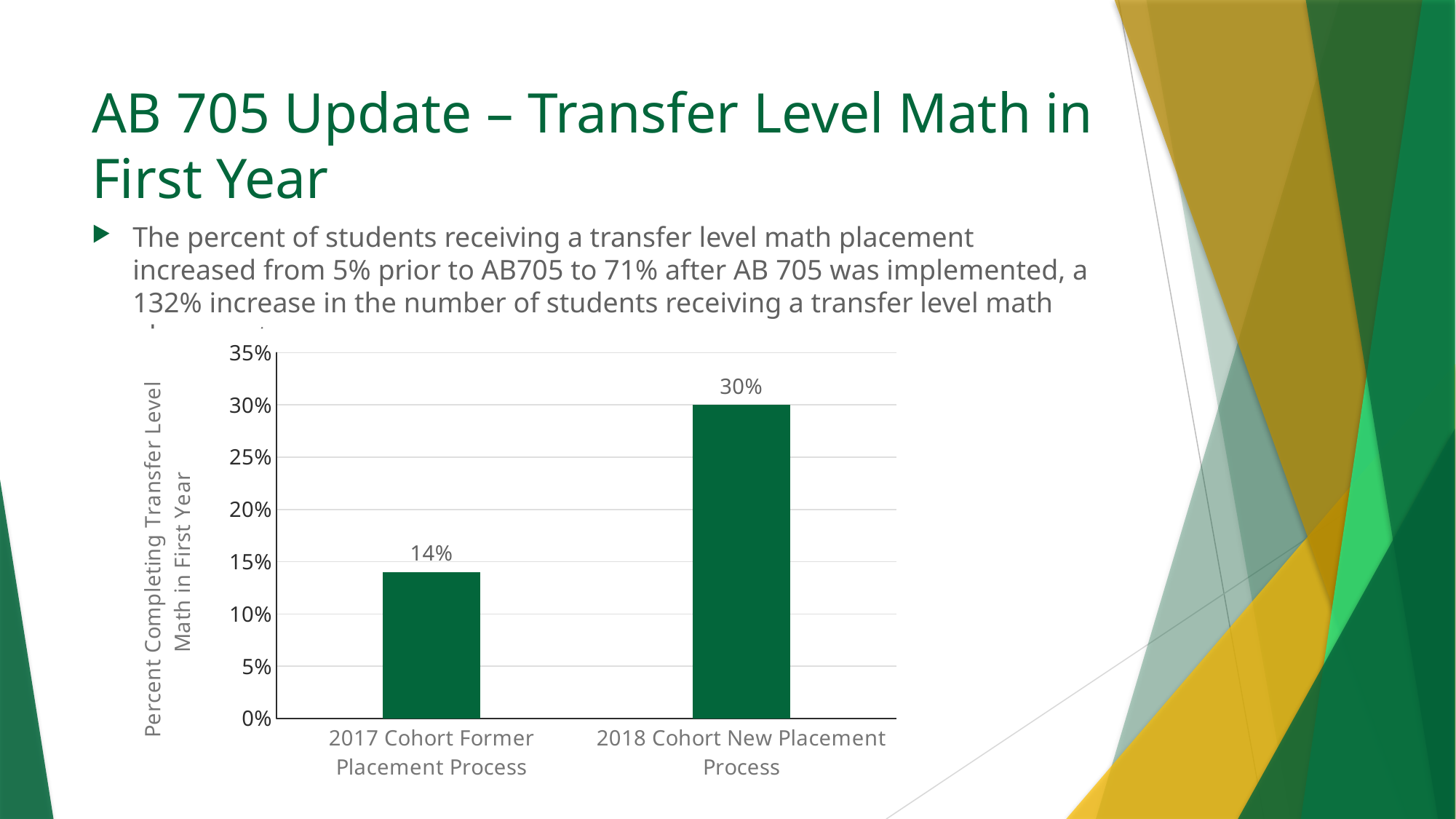
What is the label of the vertical axis? Percent Completing Transfer Level Math in First Year How many categories are shown on the x axis? 2 Do the values rise or fall from the 2017 cohort to the 2018 cohort? rise What is the value for 2017 Cohort Former Placement Process? 14% What kind of chart is shown on the slide? bar chart What is the difference between the values for 2018 Cohort New Placement Process and 2017 Cohort Former Placement Process? 16% Is the value for 2017 Cohort Former Placement Process greater or less than 20%? less What is the value for 2018 Cohort New Placement Process? 30% Which is larger, the value for 2017 Cohort Former Placement Process or 2018 Cohort New Placement Process? 2018 Cohort New Placement Process Which category has the highest value? 2018 Cohort New Placement Process Which category has the lowest value? 2017 Cohort Former Placement Process Is the value for 2018 Cohort New Placement Process greater or less than 25%? greater